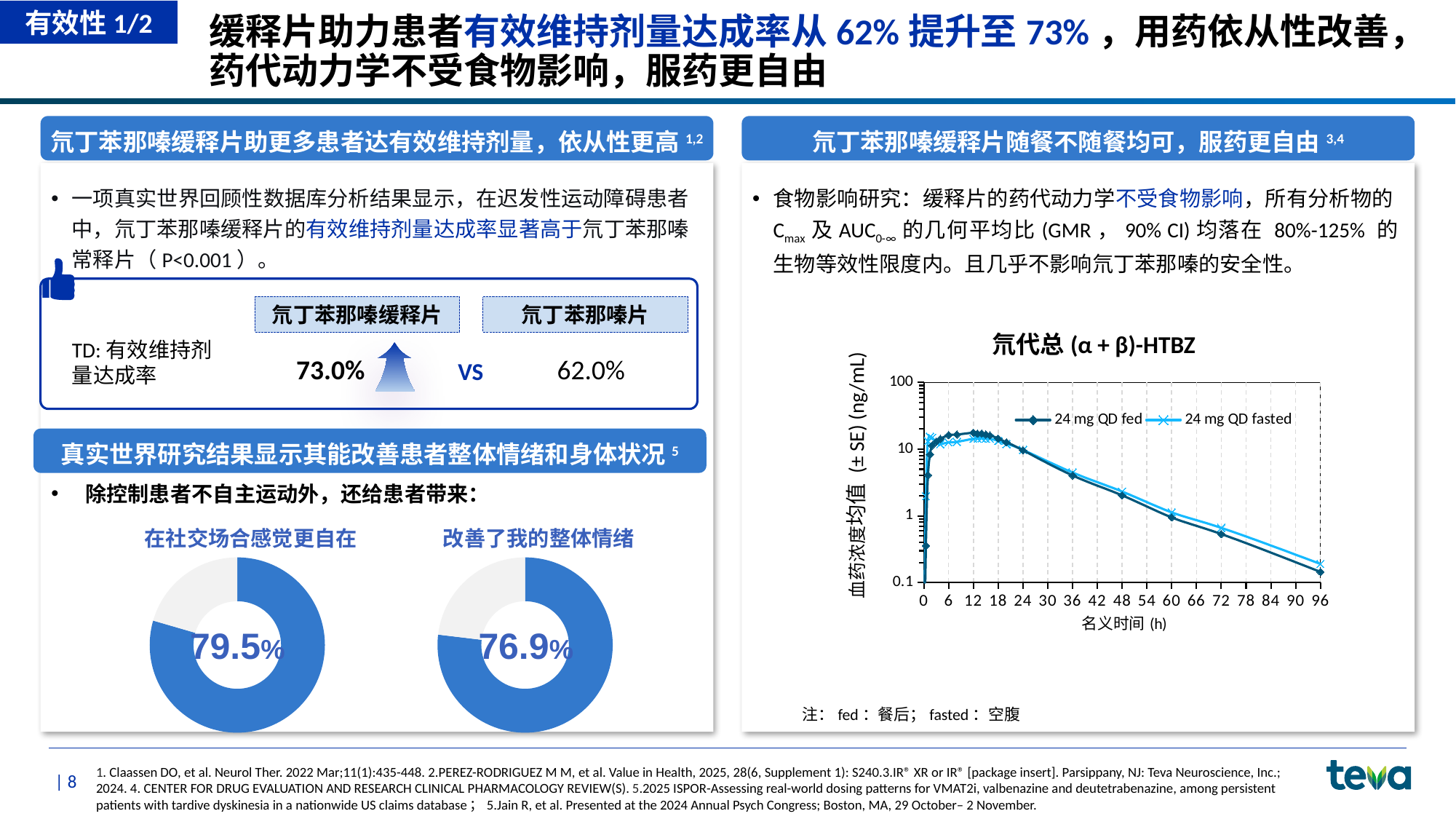
How many series does the legend of the 氘代总 (α + β)-HTBZ chart list? 2 What are the two series named in the legend of the 氘代总 (α + β)-HTBZ chart? 24 mg QD fed and 24 mg QD fasted In the donut chart titled 改善了我的整体情绪, what percentage is shown? 76.9% What is the x-axis label of the 氘代总 (α + β)-HTBZ chart? 名义时间 (h) In the 氘代总 (α + β)-HTBZ chart, is the 24 mg QD fed value at 12 h greater or less than 10? greater In the 氘代总 (α + β)-HTBZ chart, do the concentration values rise or fall along the x axis after about 18 h? Fall What kind of chart is the one titled 氘代总 (α + β)-HTBZ? Line chart What kind of chart is used to show the 79.5% and 76.9% values on the left side of the slide? Pie (donut) chart Which of the two donut charts shows the larger percentage, 在社交场合感觉更自在 or 改善了我的整体情绪? 在社交场合感觉更自在 In the donut chart titled 在社交场合感觉更自在, what percentage is shown? 79.5% In the 氘代总 (α + β)-HTBZ chart, is the 24 mg QD fed value at 96 h greater or less than 1? less What is the difference between the percentages shown in the two donut charts (79.5% and 76.9%)? 2.6%